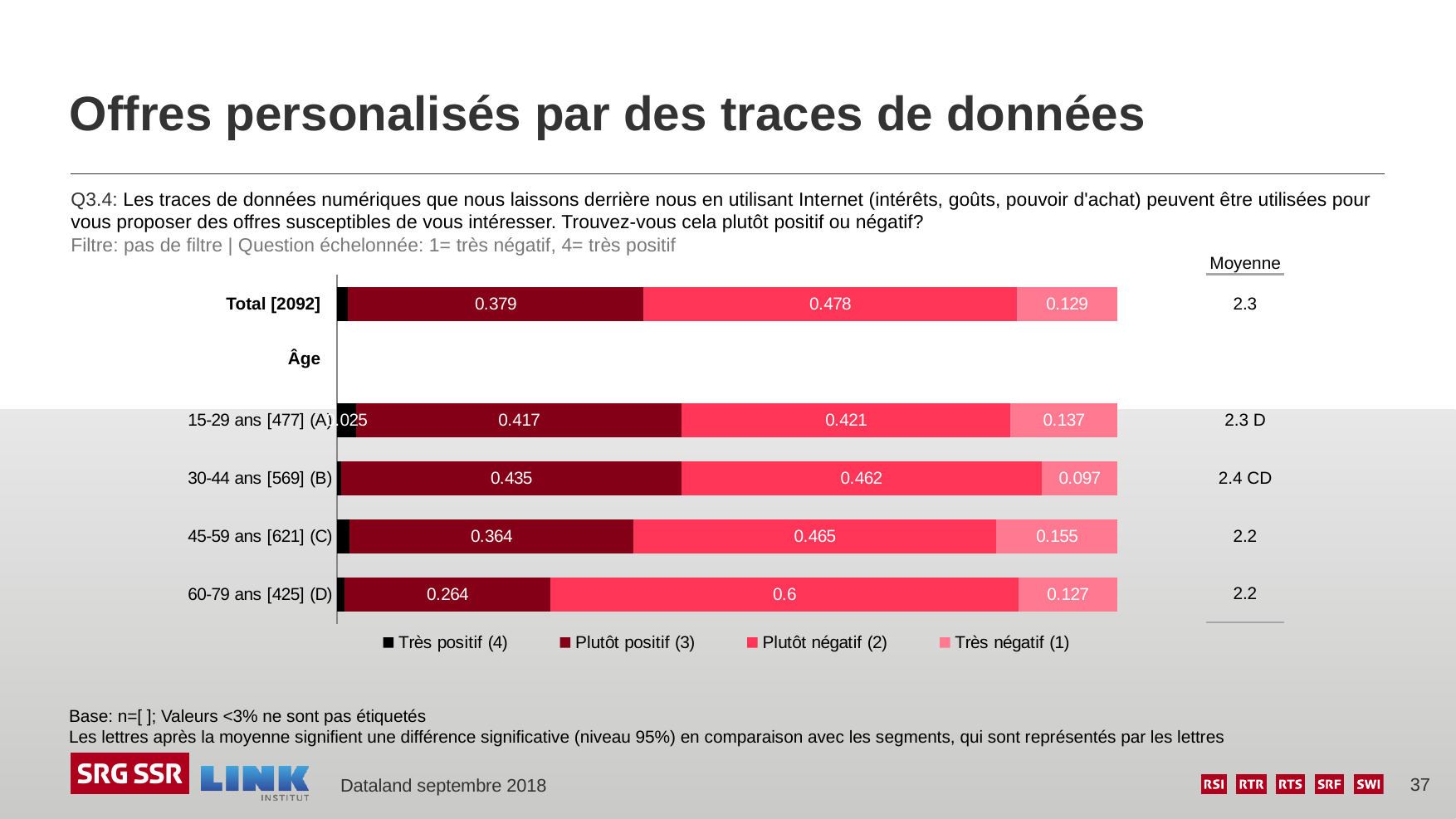
Which age group has the highest value for Plutôt positif (3)? 30-44 ans [569] (B) What is the value for Très négatif (1) for 30-44 ans [569] (B)? 0.097 What is the value for Plutôt négatif (2) for 45-59 ans [621] (C)? 0.465 What is the value for Plutôt positif (3) for Total [2092]? 0.379 Which is larger, the Plutôt négatif (2) value for 45-59 ans [621] (C) or for 15-29 ans [477] (A)? 45-59 ans [621] (C) Which age group has the highest value for Plutôt négatif (2)? 60-79 ans [425] (D) What is the difference between the Plutôt positif (3) values for 30-44 ans [569] (B) and 60-79 ans [425] (D)? 0.171 How many bars are plotted in the chart? 5 What is the value for Plutôt négatif (2) for 60-79 ans [425] (D)? 0.6 What kind of chart is shown on the slide? Stacked bar chart Which age group has the lowest value for Très négatif (1)? 30-44 ans [569] (B) How many series does the legend list? 4